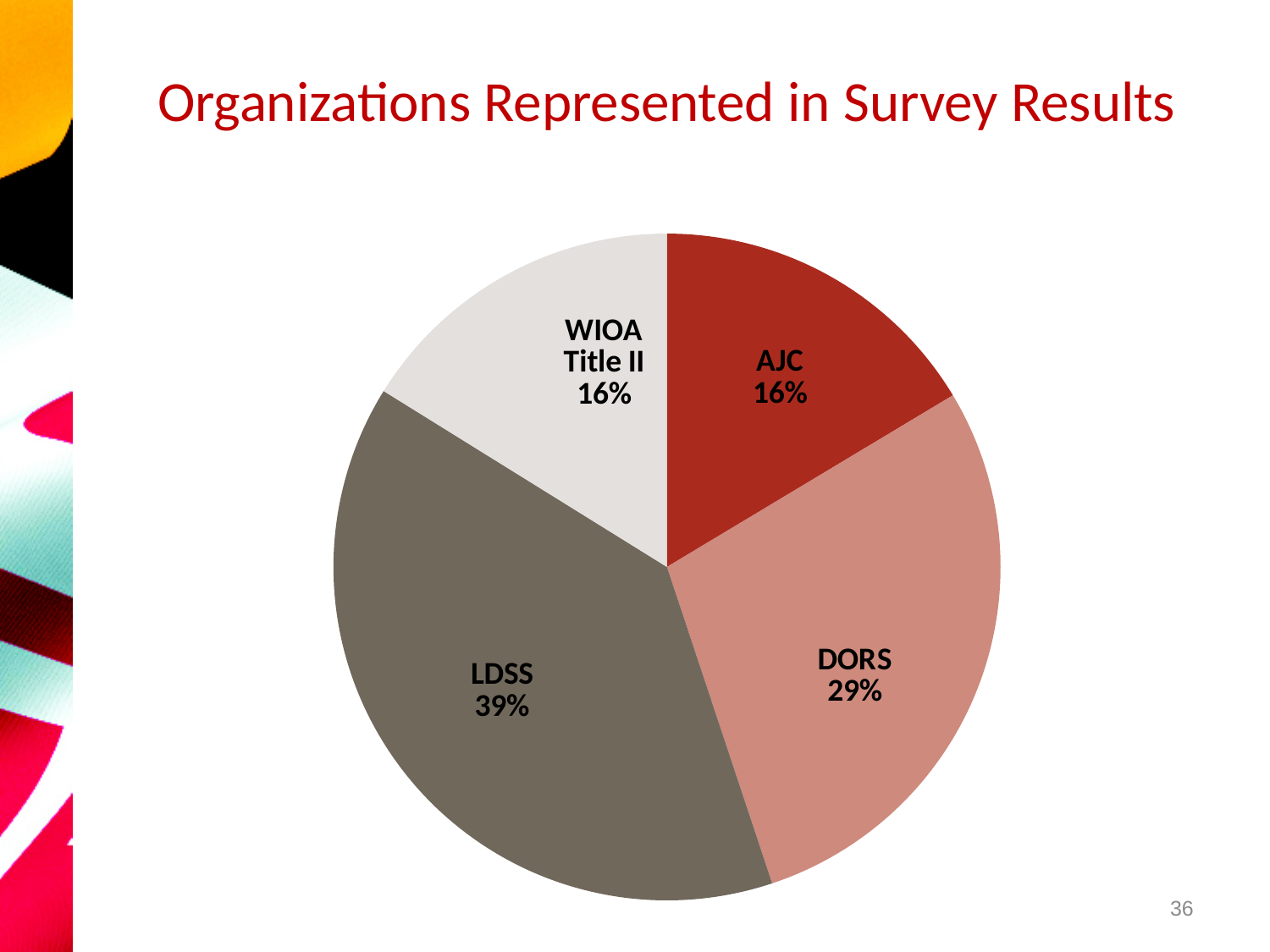
What is the title of the chart? Organizations Represented in Survey Results What share of the pie does AJC represent? 16% What kind of chart is shown on the slide? pie chart What is the difference in percentage points between LDSS and AJC? 23 Which is larger, the share for DORS or the share for AJC? DORS Which slice of the pie is the darkest red? AJC What share of the pie does LDSS represent? 39% What share of the pie does WIOA Title II represent? 16% How many slices does the pie chart have? 4 What is the difference in percentage points between LDSS and DORS? 10 Which organization has the largest share of the pie? LDSS